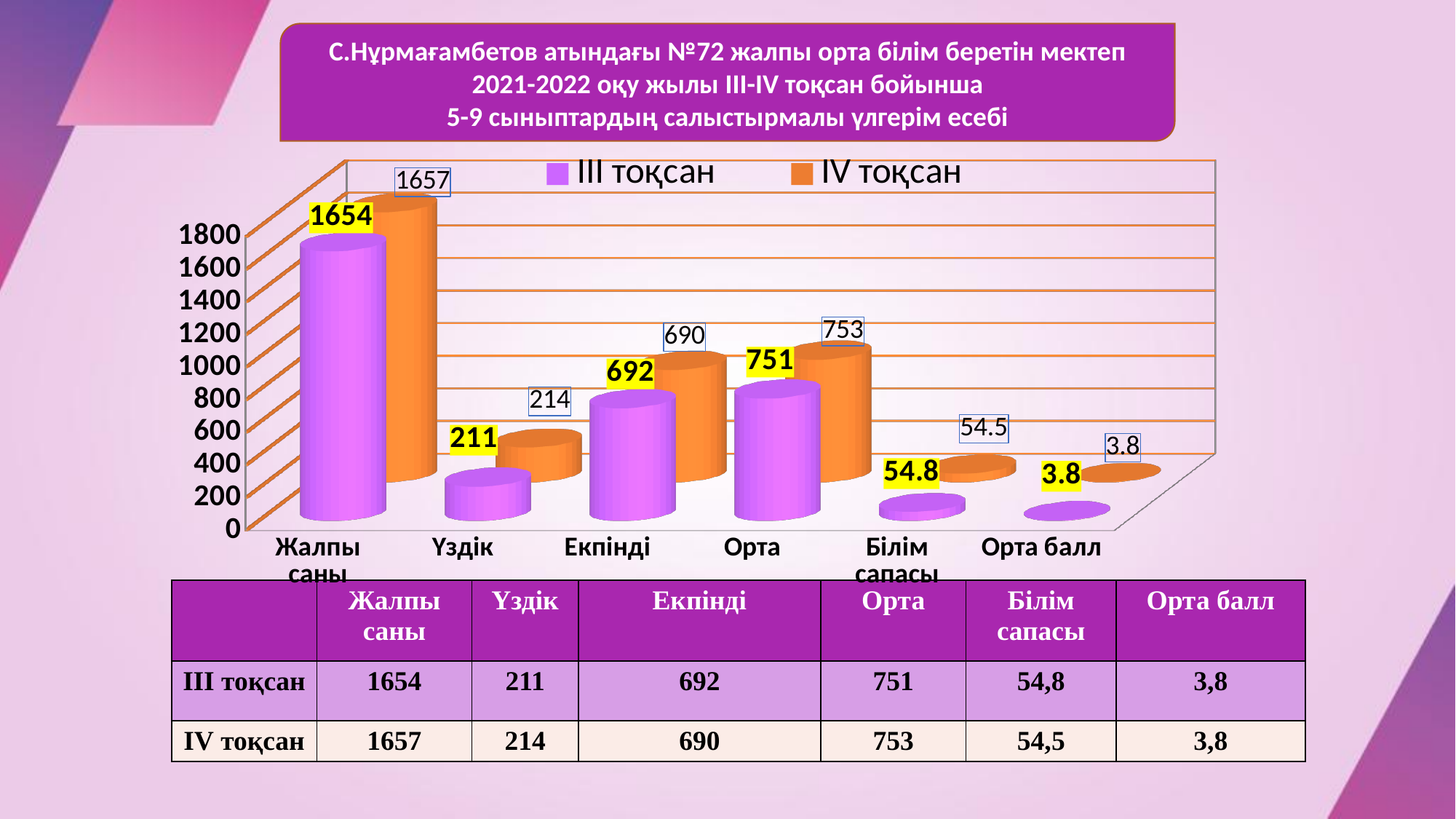
What is the value for Орта балл in the IV тоқсан series? 3.8 How many series does the chart legend list? 2 What is the value for Білім сапасы in the III тоқсан series? 54.8 What is the value for Үздік in the IV тоқсан series? 214 Which category has the lowest value in the IV тоқсан series? Орта балл What kind of chart is shown on the slide? Bar chart How many categories are shown on the x axis of the chart? 6 Which is larger for Екпінді: the III тоқсан value or the IV тоқсан value? III тоқсан What is the value for Жалпы саны in the IV тоқсан series? 1657 What is the difference between the IV тоқсан and III тоқсан values for Орта? 2 Which category has the highest value in the III тоқсан series? Жалпы саны What is the value for Жалпы саны in the III тоқсан series? 1654